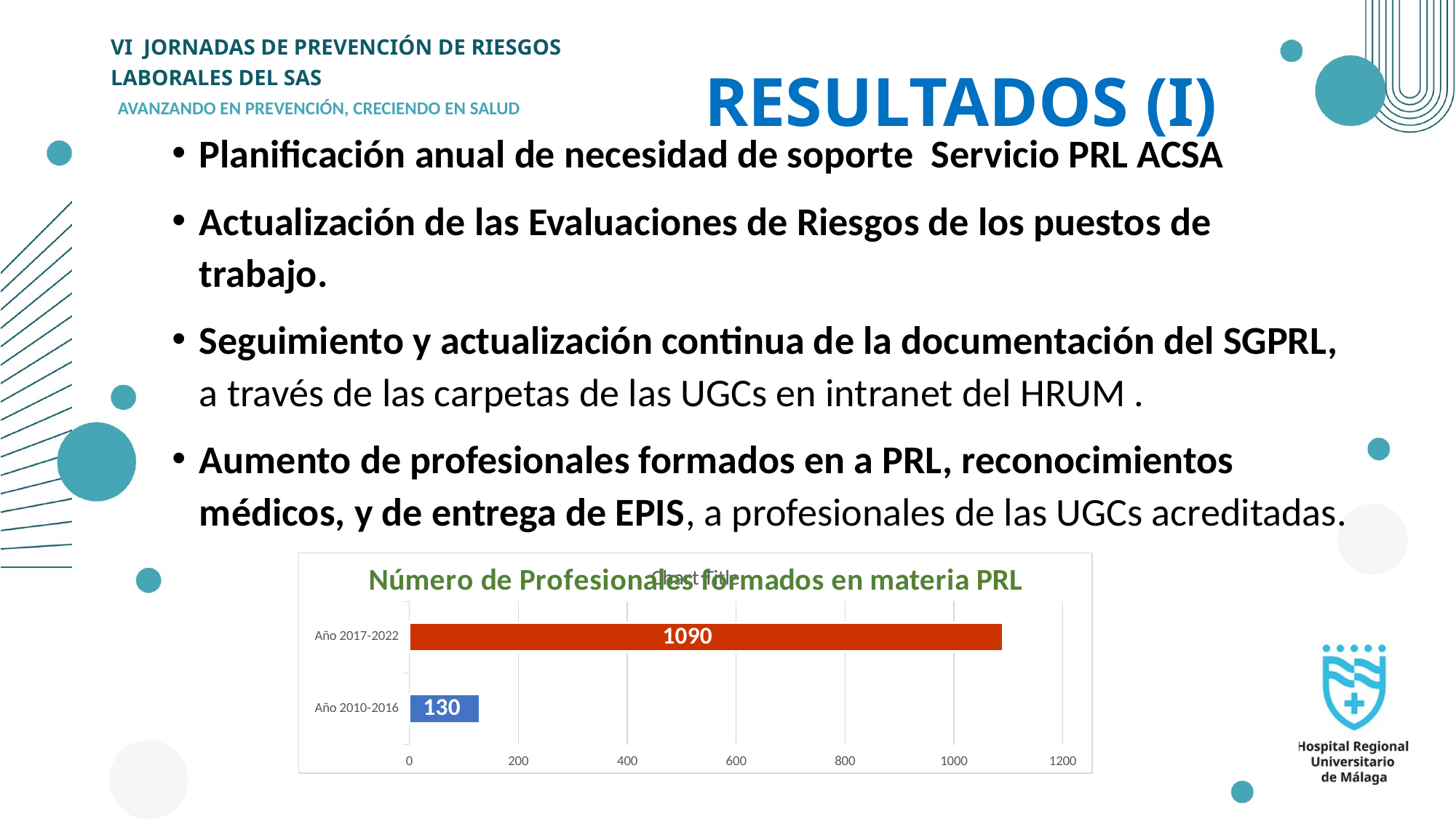
Is the value for Año 2010-2016 greater or less than 200? less What is the difference between the values for Año 2017-2022 and Año 2010-2016? 960 What is the highest value shown on the x axis of the chart? 1200 Which category has the lowest value? Año 2010-2016 What is the title of the chart? Número de Profesionales formados en materia PRL Which category has the highest value? Año 2017-2022 How many categories are shown in the chart? 2 What is the value for Año 2017-2022? 1090 Is the value for Año 2017-2022 greater or less than 1000? greater Which is larger, the value for Año 2010-2016 or the value for Año 2017-2022? Año 2017-2022 What is the value for Año 2010-2016? 130 What kind of chart is shown on the slide? bar chart